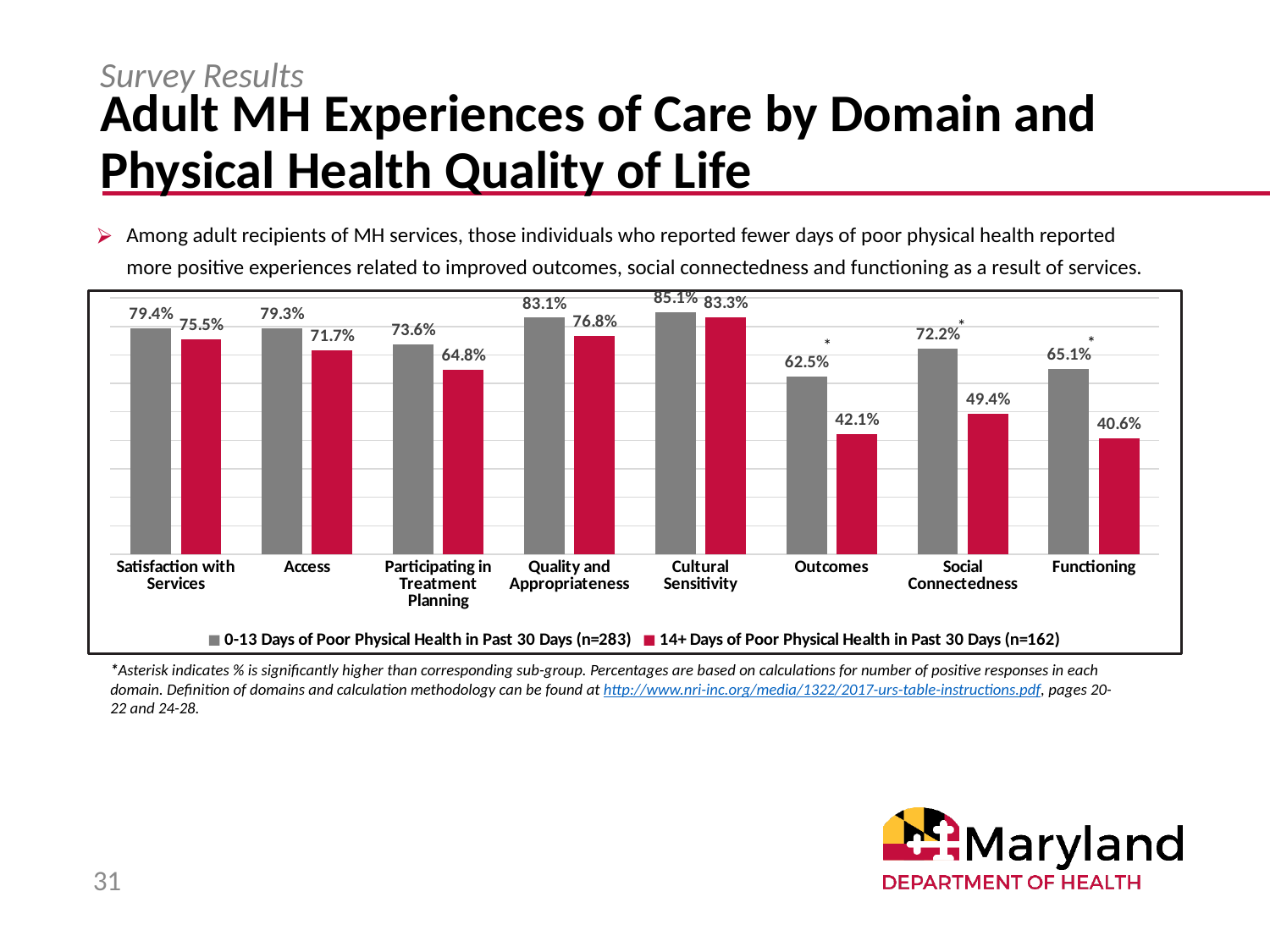
What is the value for Social Connectedness in the 14+ Days of Poor Physical Health in Past 30 Days (n=162) series? 49.4% What is the difference between the two series for Social Connectedness? 22.8% Which domain has the lowest value in the 14+ Days of Poor Physical Health in Past 30 Days (n=162) series? Functioning How many series does the legend list? 2 What kind of chart is shown on the slide? Bar chart Which domain has the highest value in the 0-13 Days of Poor Physical Health in Past 30 Days (n=283) series? Cultural Sensitivity What is the value for Quality and Appropriateness in the 0-13 Days of Poor Physical Health in Past 30 Days (n=283) series? 83.1% For Access, which series has the larger value: 0-13 Days of Poor Physical Health or 14+ Days of Poor Physical Health? 0-13 Days of Poor Physical Health in Past 30 Days (n=283) What is the difference between the two series for Outcomes? 20.4% How many domains are shown on the x axis of the chart? 8 What is the value for Outcomes in the 0-13 Days of Poor Physical Health in Past 30 Days (n=283) series? 62.5% What is the value for Functioning in the 14+ Days of Poor Physical Health in Past 30 Days (n=162) series? 40.6%